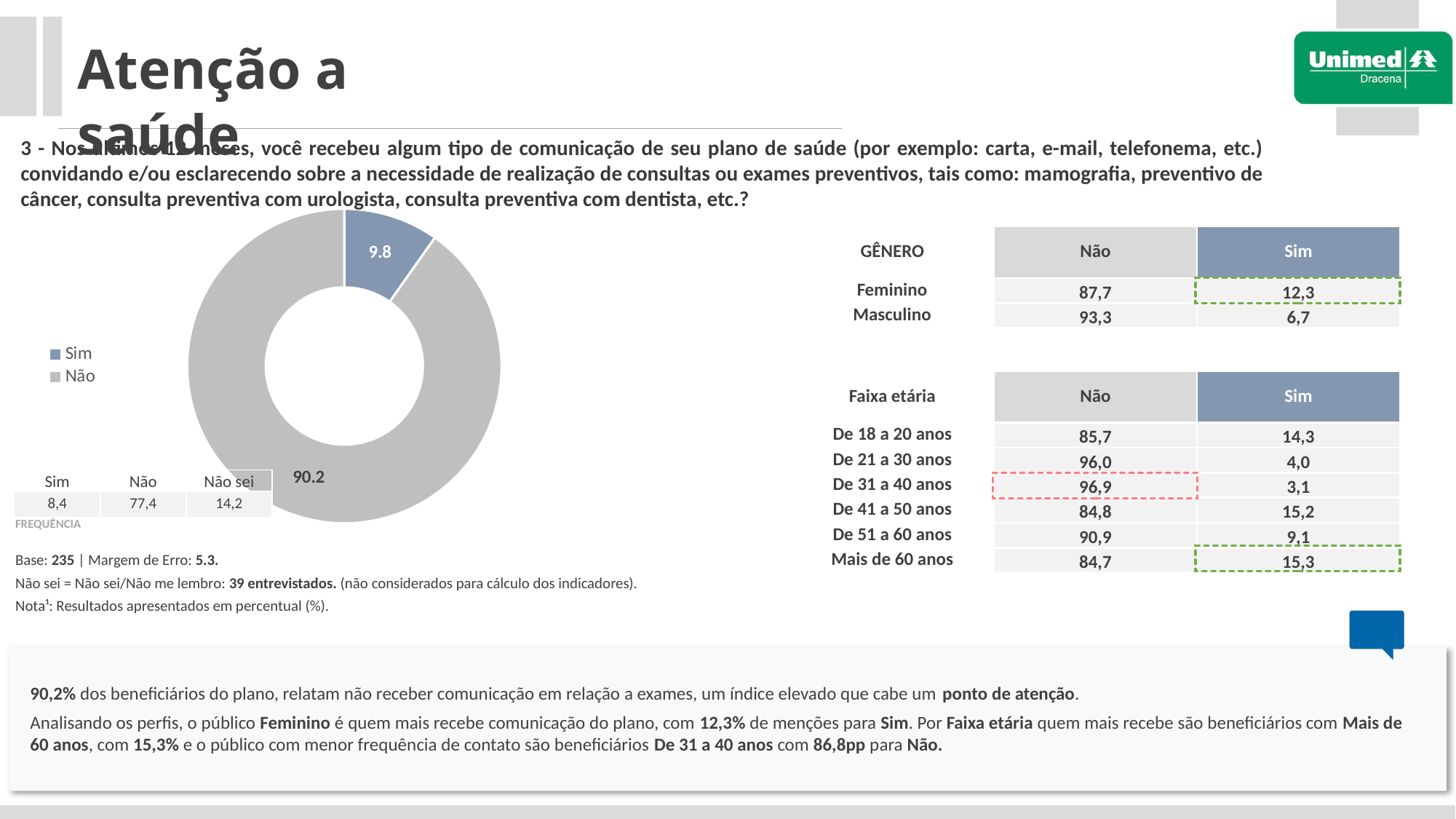
What value is shown for the Não slice of the donut chart? 90.2 What is the difference between the Não and Sim values in the donut chart? 80.4 How many entries does the legend of the donut chart list? 2 What share of the donut chart does the Sim slice represent? 9.8 What value is shown for the Sim slice of the donut chart? 9.8 Which slice of the donut chart is the smallest? Sim How many slices does the donut chart have? 2 In the donut chart, which is larger: Sim or Não? Não What kind of chart is shown on the left of the slide? Donut (pie) chart Which colour represents Sim in the donut chart's legend? Blue What is the total of the two values shown in the donut chart? 100 Which slice of the donut chart is the largest? Não